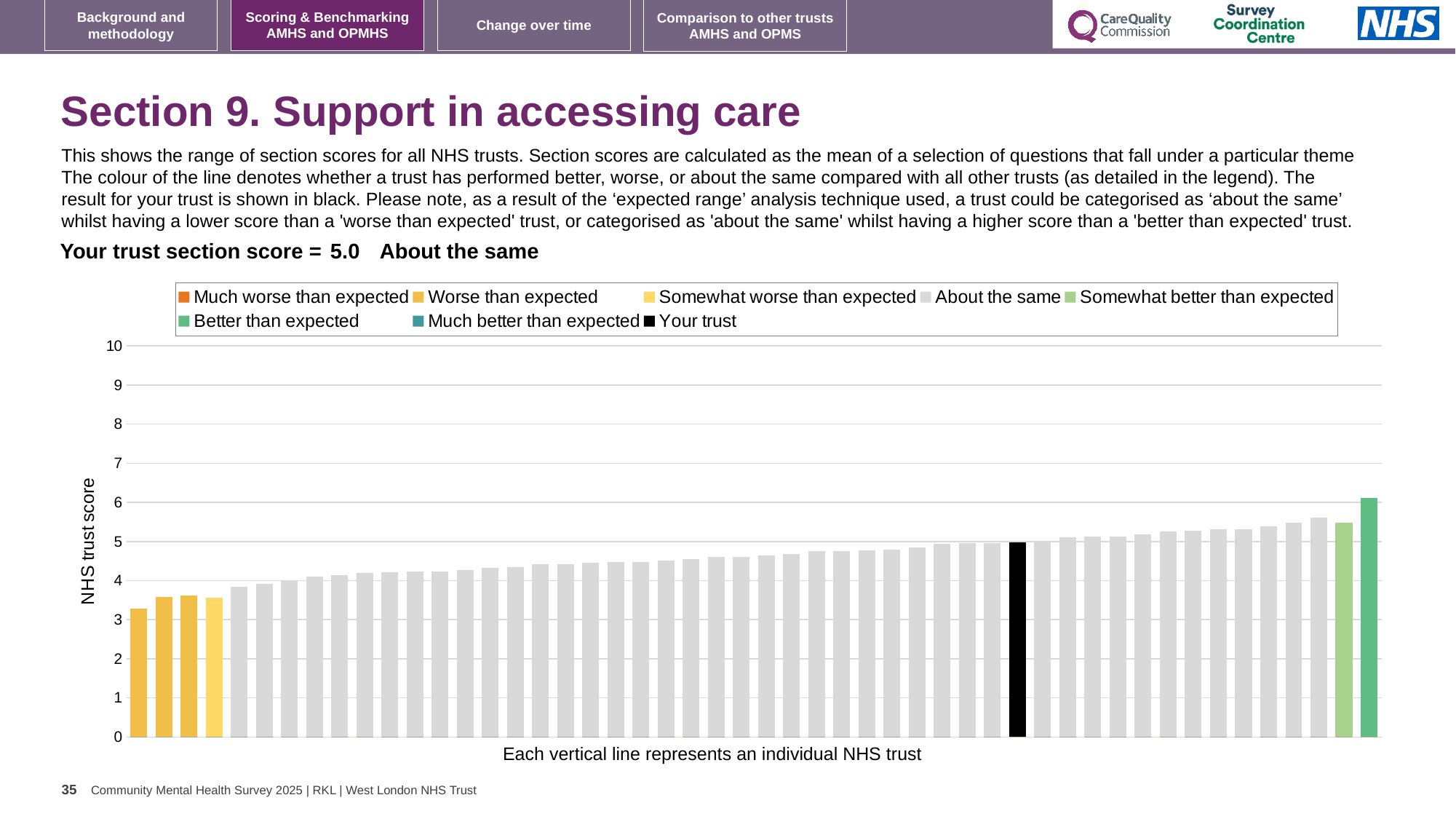
How many entries does the chart legend list? 8 According to the legend, what colour represents 'Your trust'? black Is the value of the black 'Your trust' bar greater or less than 6? less Is the value of the rightmost bar greater or less than 5? greater Do the bar values rise or fall from left to right along the x axis? rise Is the value of the black 'Your trust' bar greater or less than 4? greater Which category is your trust placed in for this section? About the same What is the label on the vertical axis of the chart? NHS trust score Which is larger, the rightmost bar or the black 'Your trust' bar? the rightmost bar What is the section score for your trust shown on the slide? 5.0 What kind of chart is shown on the slide? bar chart